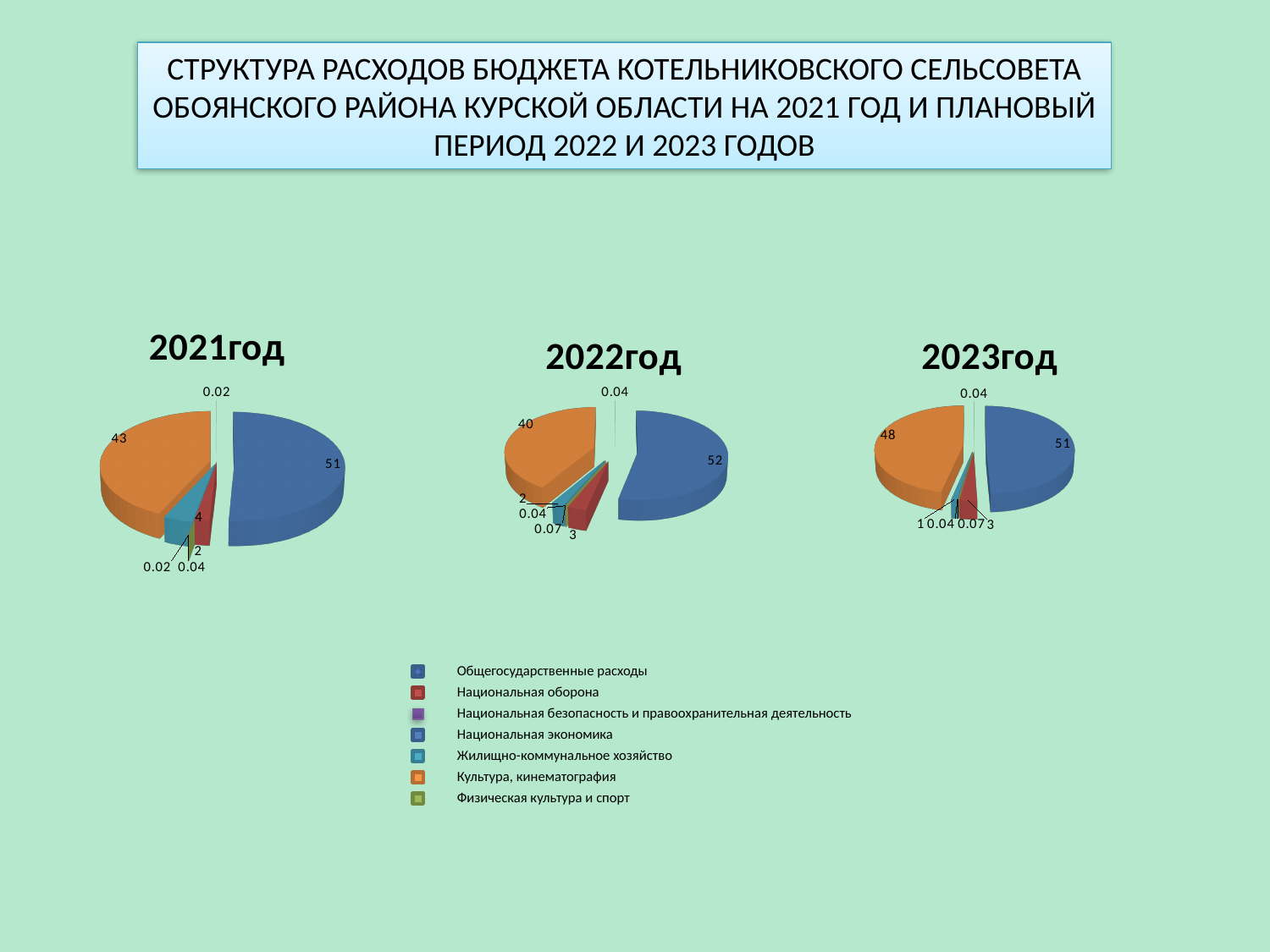
What colour represents Культура, кинематография in the legend? Orange How many categories does the legend list? 7 In the 2022год chart, which is larger: Общегосударственные расходы or Культура, кинематография? Общегосударственные расходы What kind of charts are shown on the slide? Pie charts In the 2023год chart, what is the difference between the Общегосударственные расходы slice and the Культура, кинематография slice? 3 How many pie charts are on the slide? 3 In the 2023год chart, what is the value for Культура, кинематография? 48 In the 2022год chart, what is the value for Общегосударственные расходы? 52 In the 2021год chart, what is the value for Культура, кинематография? 43 In the 2021год chart, what is the difference between the Общегосударственные расходы slice and the Культура, кинематография slice? 8 In the 2021год chart, what is the value of the largest slice? 51 In the 2021год chart, what is the value for Жилищно-коммунальное хозяйство? 4